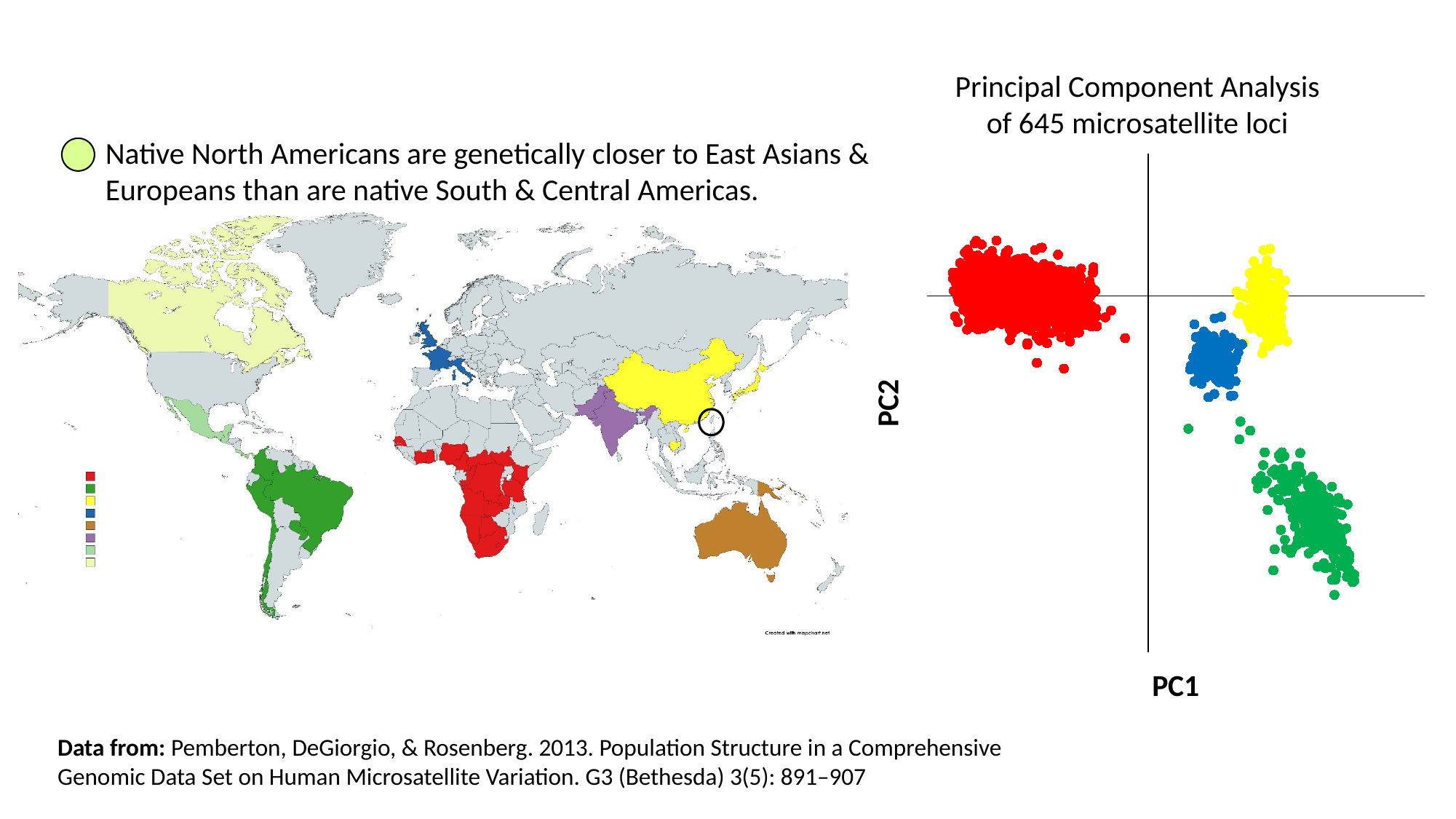
What is the title of the chart on the right of the slide? Principal Component Analysis of 645 microsatellite loci In the Principal Component Analysis chart, which coloured cluster lies to the left of the vertical PC2 axis? red In the Principal Component Analysis chart, how many distinctly coloured clusters of points are plotted? 4 In the Principal Component Analysis chart, which coloured cluster is furthest to the right along PC1? green What kind of chart is the Principal Component Analysis chart on the right of the slide? scatter plot In the Principal Component Analysis chart, is the green cluster to the right or to the left of the blue cluster on PC1? right In the Principal Component Analysis chart, which coloured cluster is furthest to the left along PC1? red In the Principal Component Analysis chart, which coloured cluster is lowest along the PC2 axis? green In the Principal Component Analysis chart, which cluster contains more points, the red cluster or the blue cluster? red In the Principal Component Analysis chart, what is the label of the horizontal axis? PC1